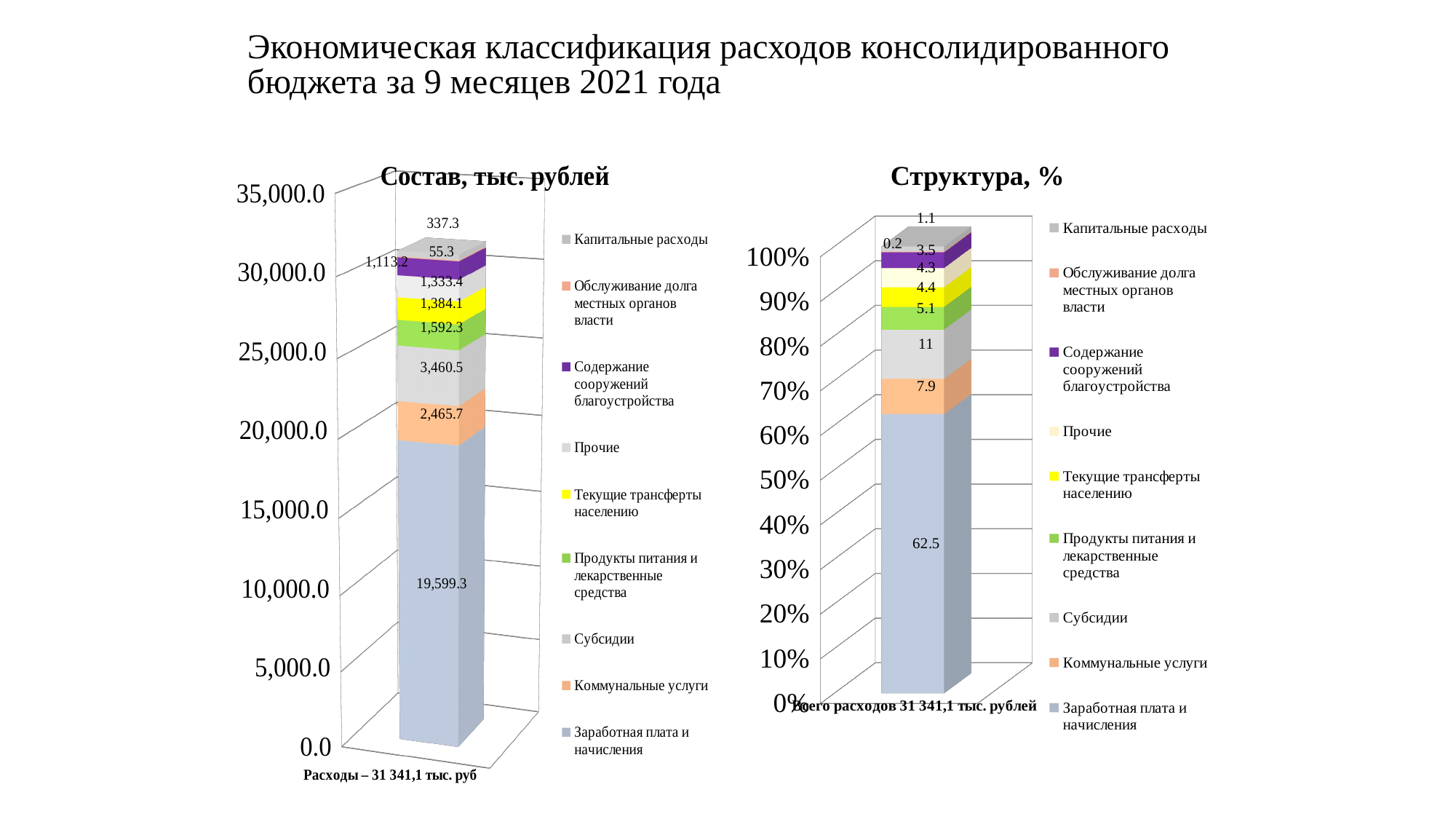
How many series does the legend of the chart titled "Структура, %" list? 9 In the chart titled "Состав, тыс. рублей", what is the value for "Заработная плата и начисления"? 19,599.3 In the chart titled "Структура, %", what is the value for "Субсидии"? 11 In the chart titled "Состав, тыс. рублей", which category has the smallest value? Обслуживание долга местных органов власти In the chart titled "Состав, тыс. рублей", what is the difference between "Субсидии" and "Коммунальные услуги"? 994.8 What kind of chart is the chart titled "Состав, тыс. рублей"? Stacked bar chart In the chart titled "Структура, %", what is the value for "Коммунальные услуги"? 7.9 In the chart titled "Структура, %", what is the value for "Капитальные расходы"? 1.1 In the chart titled "Состав, тыс. рублей", which is larger: "Продукты питания и лекарственные средства" or "Текущие трансферты населению"? Продукты питания и лекарственные средства In the chart titled "Состав, тыс. рублей", what is the total of the stacked bar? 31 341,1 тыс. руб In the chart titled "Состав, тыс. рублей", what is the value for "Субсидии"? 3,460.5 In the chart titled "Состав, тыс. рублей", which category has the largest value? Заработная плата и начисления